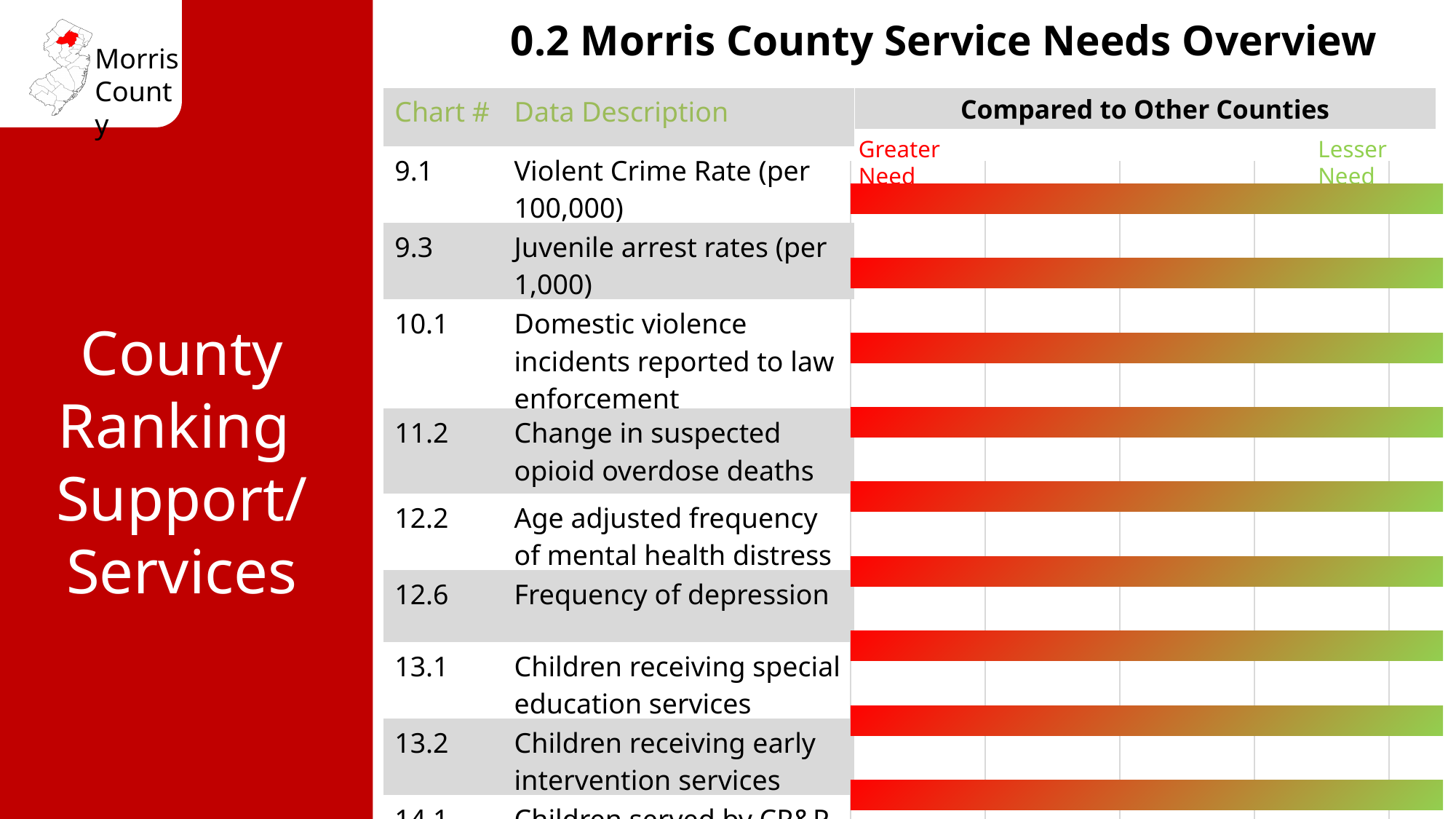
How many data descriptions listed have a chart number beginning with 13? 2 What is the chart number listed for 'Change in suspected opioid overdose deaths'? 11.2 What is the chart number listed for 'Frequency of depression'? 12.6 What is the chart number listed for 'Violent Crime Rate (per 100,000)'? 9.1 What is the chart number listed for 'Juvenile arrest rates (per 1,000)'? 9.3 Which data description is listed for chart number 12.2? Age adjusted frequency of mental health distress Which data description is listed for chart number 10.1? Domestic violence incidents reported to law enforcement Which data description is listed for chart number 13.2? Children receiving early intervention services What is the title of the slide containing the chart? 0.2 Morris County Service Needs Overview What label appears at the left (red) end of the comparison scale? Greater Need